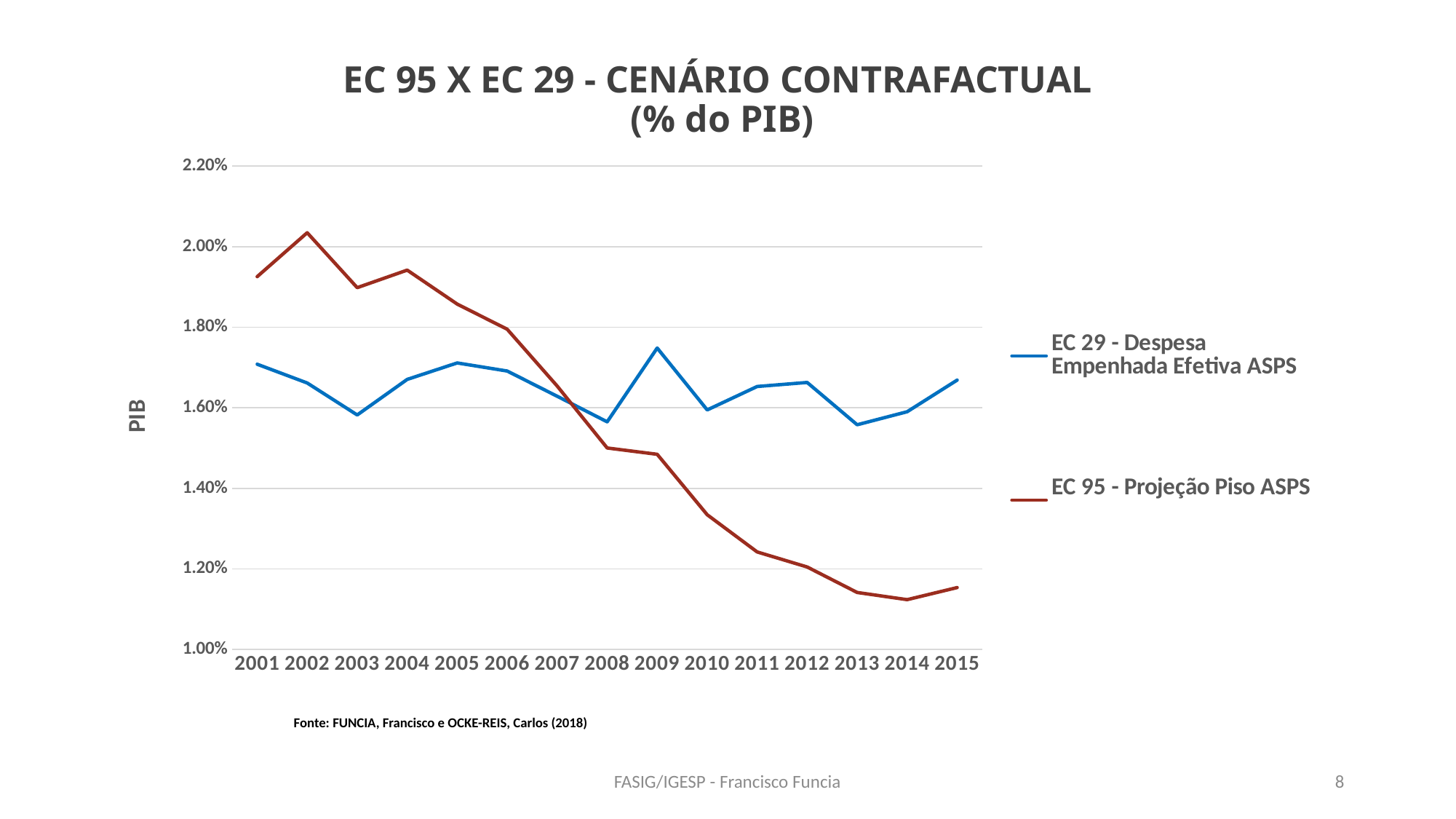
In 2001, which series has the higher value? EC 95 - Projeção Piso ASPS What kind of chart is shown on the slide? Line chart In which year does the EC 95 - Projeção Piso ASPS series reach its lowest value? 2014 Is the value for EC 95 - Projeção Piso ASPS in 2010 greater or less than 1.40%? less In which year does the EC 95 - Projeção Piso ASPS series reach its highest value? 2002 Does the EC 95 - Projeção Piso ASPS series generally rise or fall from 2001 to 2015? Fall How many series does the legend list? 2 In 2015, which series has the higher value? EC 29 - Despesa Empenhada Efetiva ASPS In which year does the EC 29 - Despesa Empenhada Efetiva ASPS series reach its highest value? 2009 How many years are shown on the x axis? 15 Is the value for EC 95 - Projeção Piso ASPS in 2014 greater or less than 1.20%? less Is the value for EC 29 - Despesa Empenhada Efetiva ASPS in 2009 greater or less than 1.60%? greater